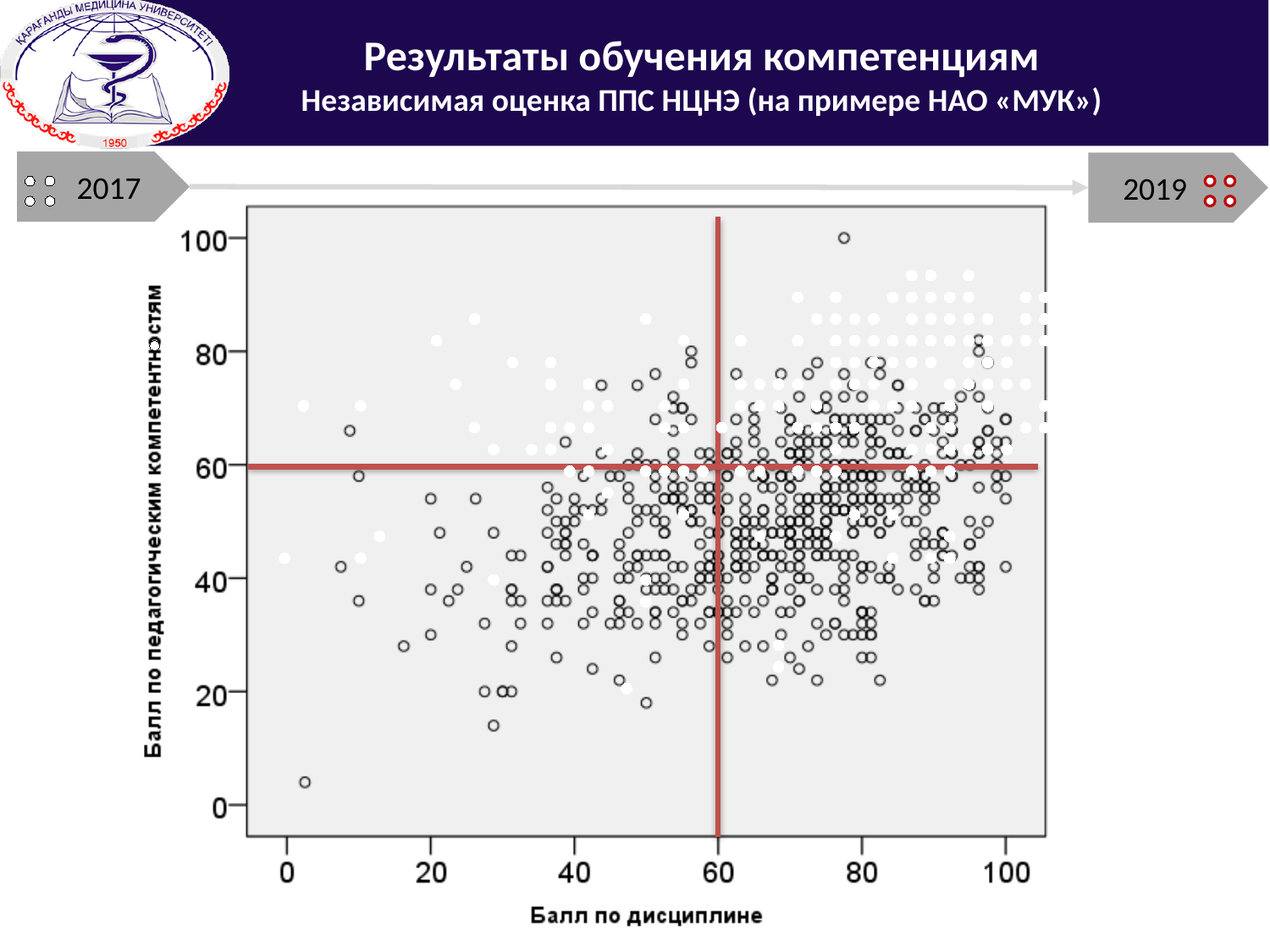
What is the label of the vertical (y) axis of the chart? Балл по педагогическим компетентностям At what value on the y axis is the horizontal red reference line drawn? 60 Do the white (2019) points generally lie higher or lower on the y axis than the black-outlined (2017) points? higher Which two years are compared on the slide? 2017 and 2019 What is the highest tick value shown on the y axis? 100 At what value on the x axis is the vertical red reference line drawn? 60 What is the label of the horizontal (x) axis of the chart? Балл по дисциплине How many years (series) are indicated above the chart? 2 Is the y value of the lowest point on the chart (near x = 0) greater or less than 20? less Is the x value of the point at the very top of the chart (y = 100) greater or less than 60? greater Do the y values generally rise or fall as the x value increases? rise What kind of chart is shown on the slide? scatter plot